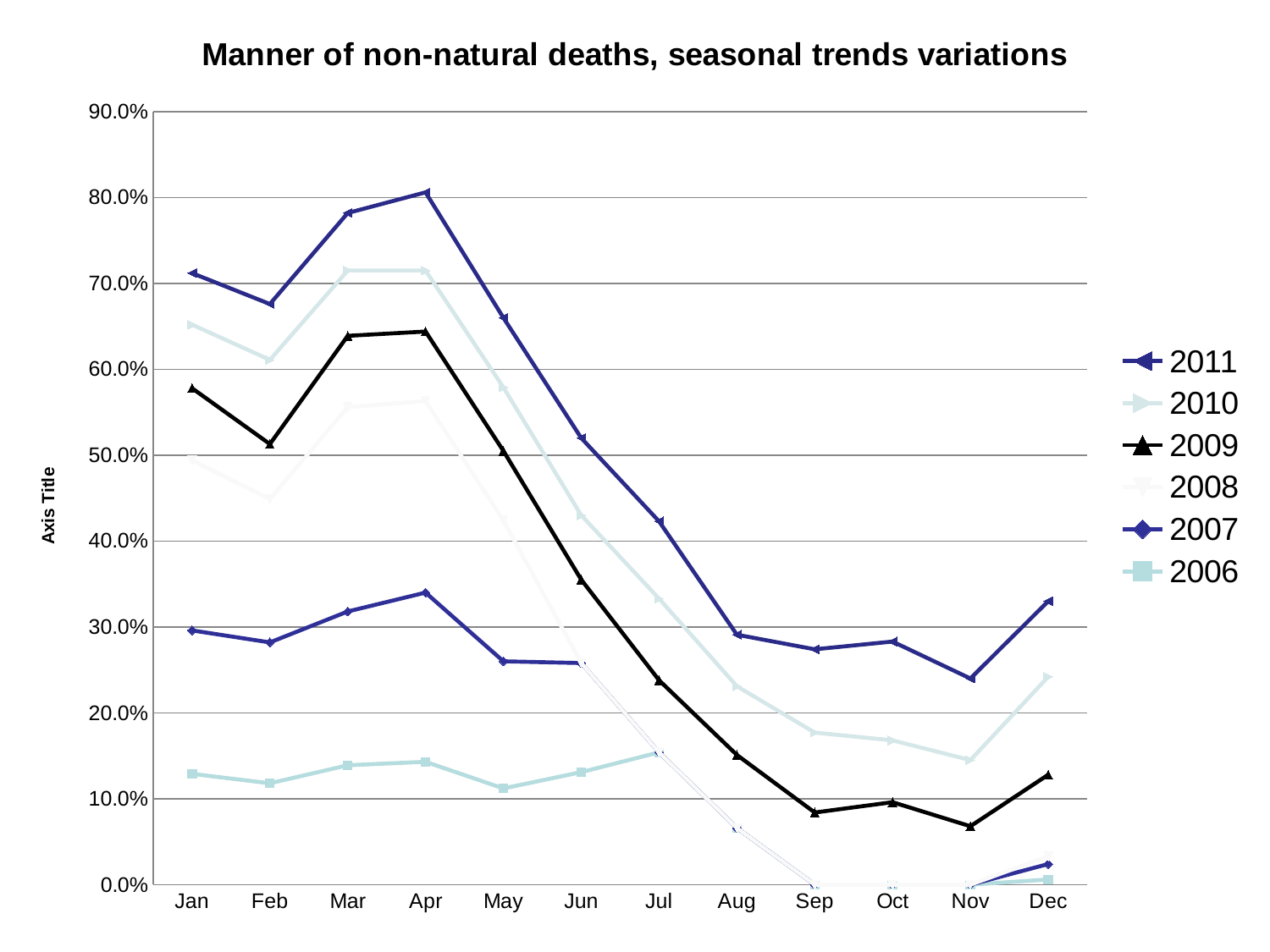
Is the value for 2009 in Feb greater or less than 60.0%? less How many series does the legend list? 6 In which month does the 2007 series reach its highest value? Apr What kind of chart is shown on the slide? Line chart Is the value for 2010 in Nov greater or less than 20.0%? less What is the title of the chart? Manner of non-natural deaths, seasonal trends variations How many months are plotted along the x axis? 12